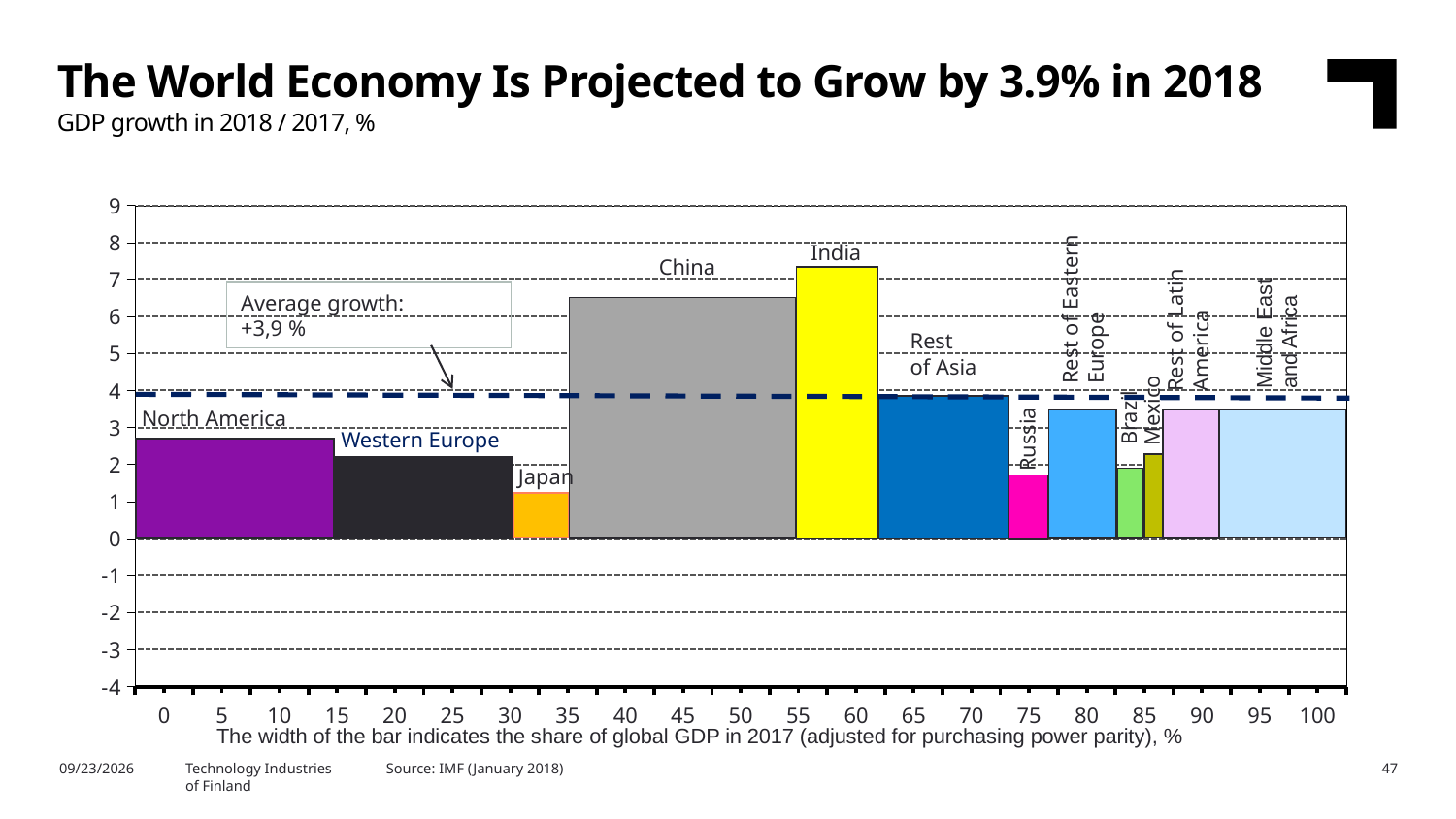
Which has the higher projected GDP growth, Western Europe or Japan? Western Europe Is the value for Japan greater or less than 2? less According to the note below the x axis, what does the width of each bar indicate? The share of global GDP in 2017 (adjusted for purchasing power parity), % Which region has the lowest projected GDP growth in the chart? Japan Which region has the highest projected GDP growth in the chart? India Is the value for China greater or less than 6? greater Is the value for Middle East and Africa greater or less than 4? less Which has the higher projected GDP growth, China or India? India What average growth value is printed on the chart? +3,9 % How many regions are shown as bars in the chart? 12 What kind of chart is shown on the slide? bar chart